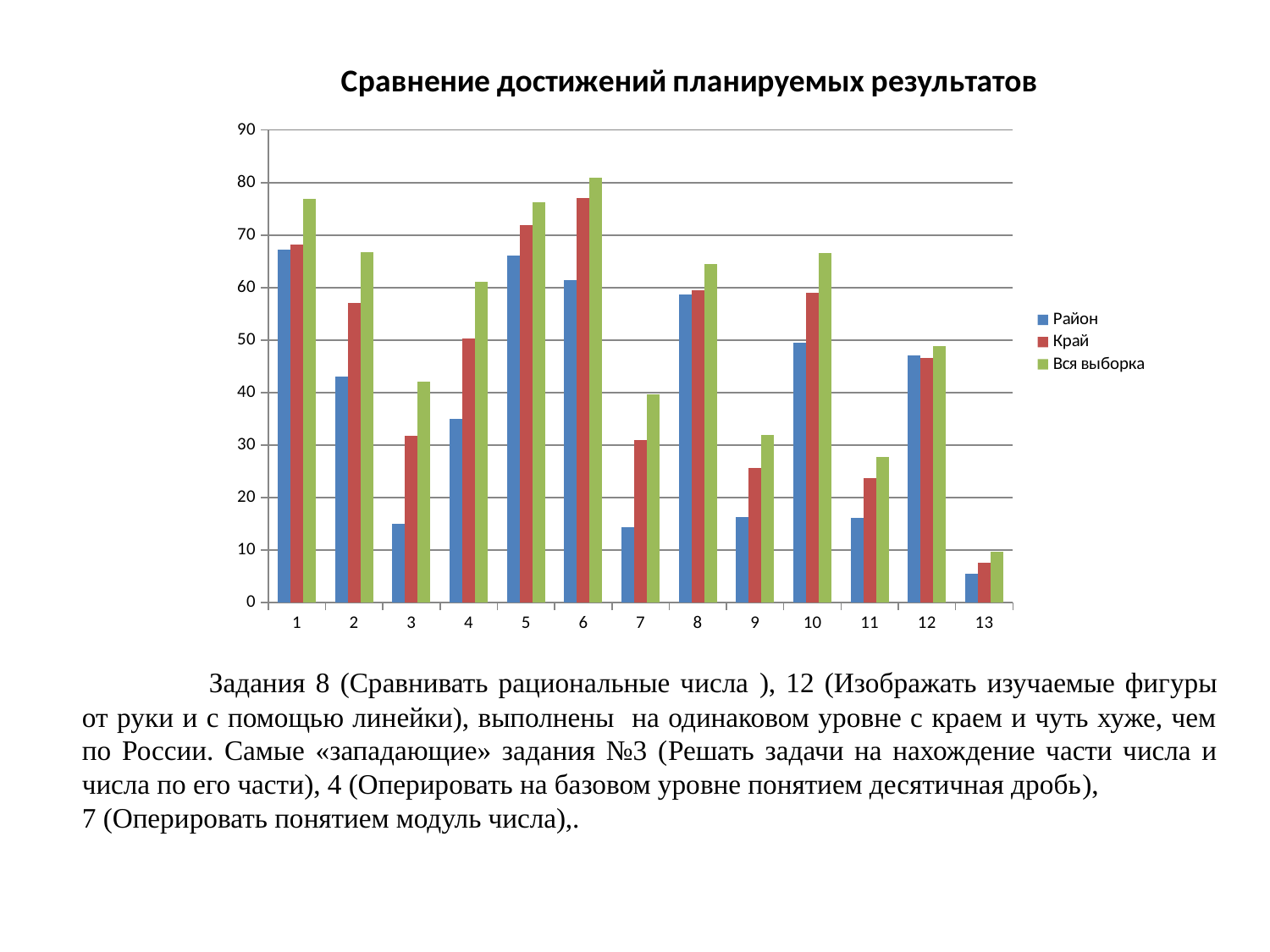
Which category has the highest value for the series Вся выборка? 6 In category 6, which series has the larger value, Район or Вся выборка? Вся выборка What kind of chart is shown on the slide? bar chart Which category has the highest value for the series Край? 6 Is the value for Край in category 2 greater or less than 50? greater How many series does the legend list? 3 Is the value for Вся выборка in category 4 greater or less than 50? greater What is the title of the chart? Сравнение достижений планируемых результатов How many categories are shown on the x axis? 13 Is the value for Район in category 3 greater or less than 20? less In category 3, which series has the larger value, Район or Край? Край Which category has the lowest value for the series Район? 13